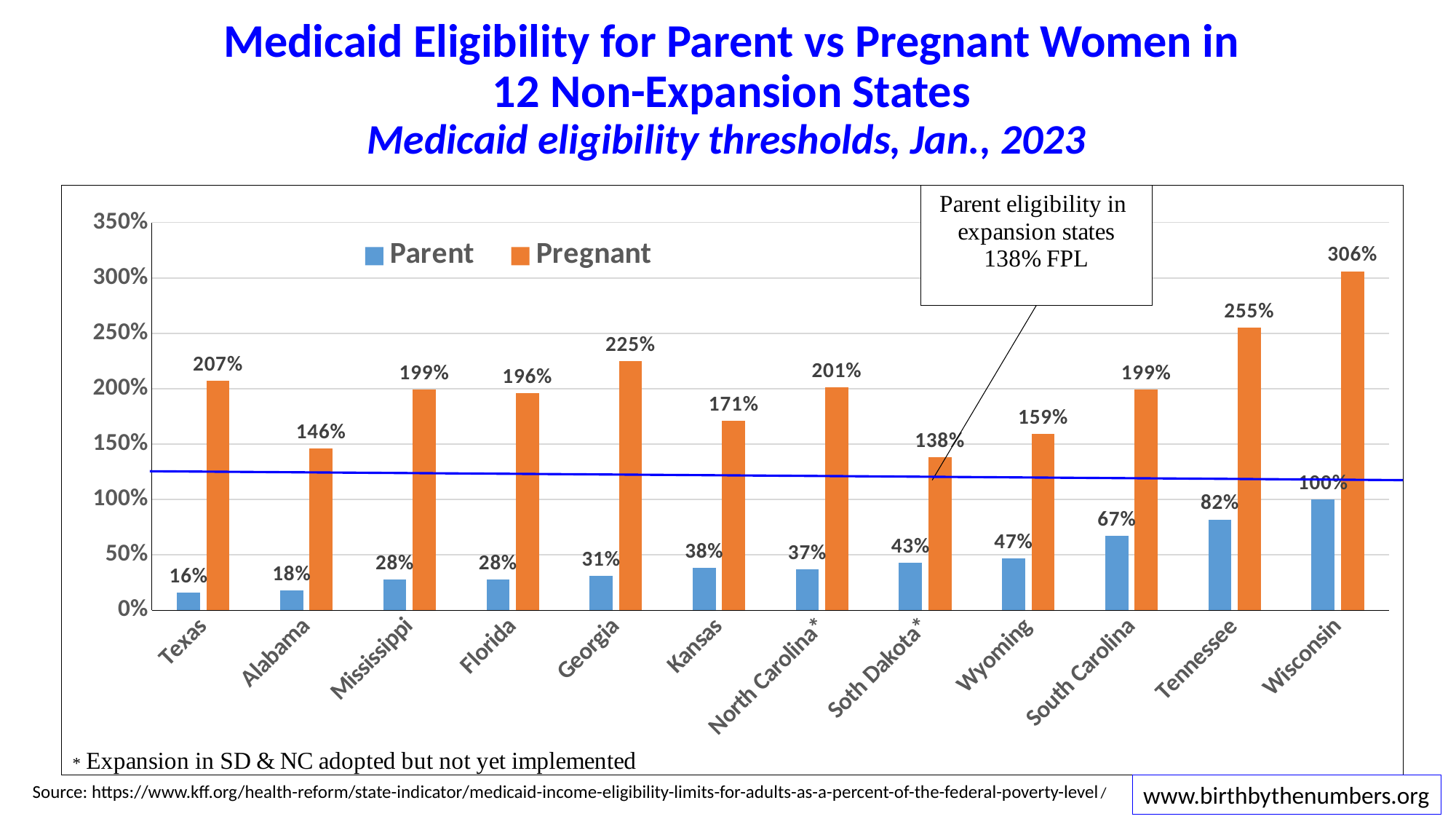
Do the Parent thresholds rise or fall from Texas to Wisconsin? Rise How many series does the legend list? 2 Which state has the lowest Parent eligibility threshold? Texas Which state has the highest Pregnant eligibility threshold? Wisconsin Is the Pregnant threshold for Wyoming greater or less than 150%? greater What is the Pregnant eligibility threshold for Texas? 207% What kind of chart is shown? Bar chart How many states are shown on the x axis? 12 What is the difference between the Pregnant and Parent thresholds for Georgia? 194% What is the Parent eligibility threshold for Tennessee? 82% What parent eligibility level in expansion states does the callout box state? 138% FPL Which is larger, the Pregnant threshold for Alabama or the Pregnant threshold for Kansas? Kansas